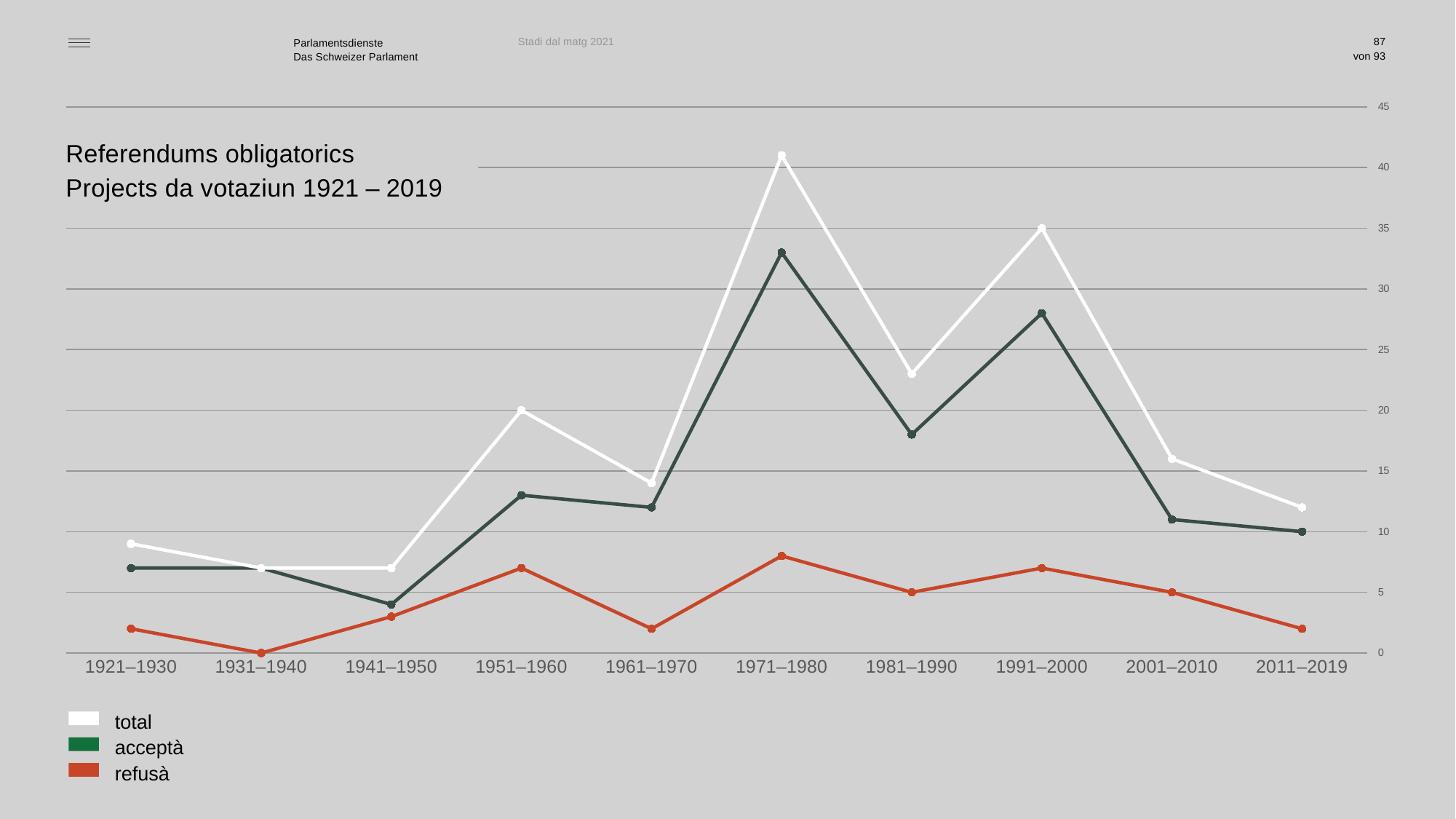
Does the total series rise or fall from 1991–2000 to 2011–2019? fall In 1971–1980, which is larger: the acceptà value or the refusà value? acceptà How many series does the legend list? 3 What is the value of the total series for 1991–2000? 35 How many periods are shown on the x axis? 10 In which period does the refusà series reach its lowest value? 1931–1940 What kind of chart is shown on the slide? line chart Is the value of the acceptà series for 1991–2000 greater or less than 25? greater Is the value of the total series for 1971–1980 greater or less than 40? greater What is the value of the refusà series for 1931–1940? 0 In which period does the total series reach its highest value? 1971–1980 What is the value of the total series for 1951–1960? 20